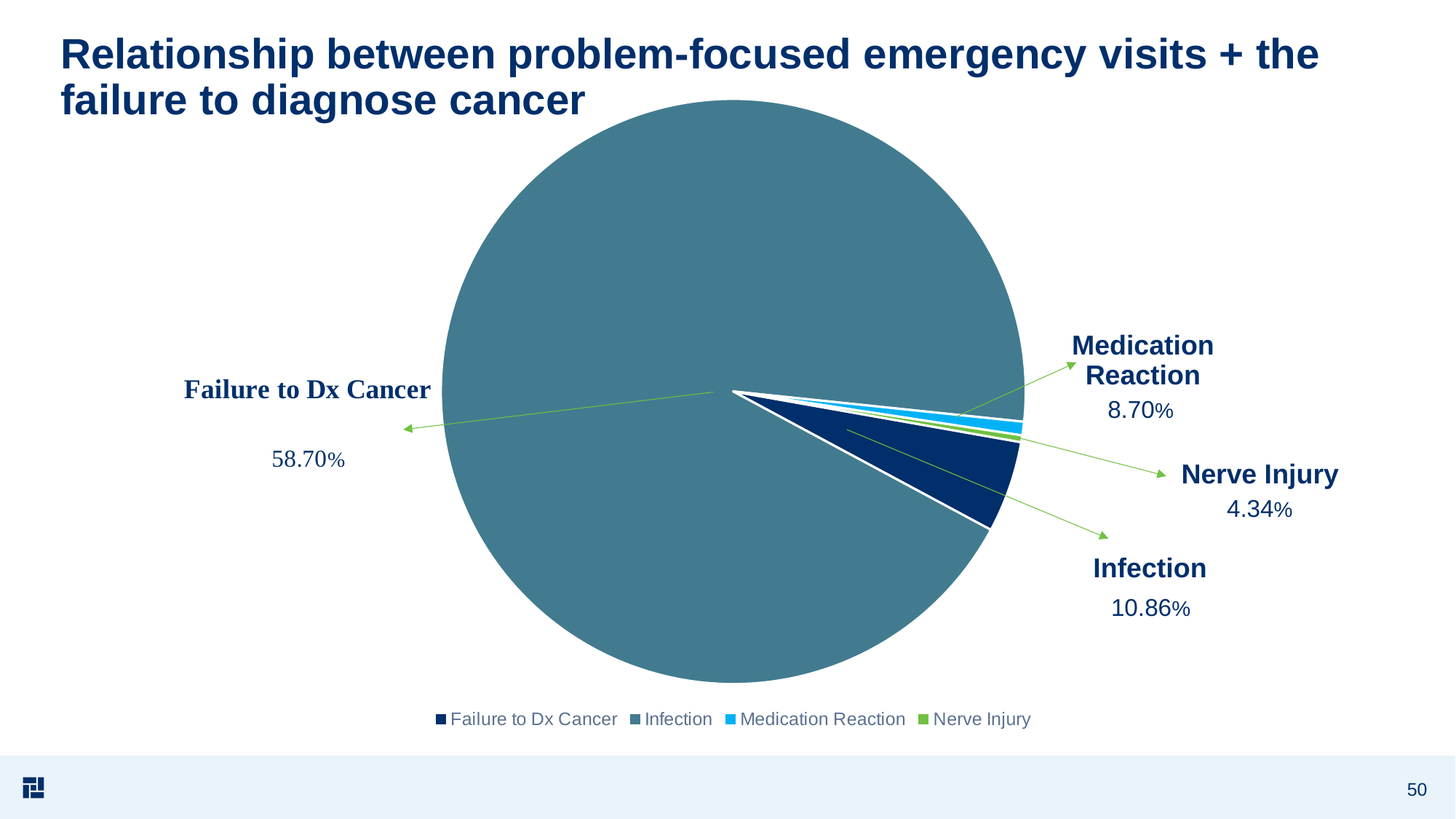
What is the difference between the Infection and Medication Reaction percentages? 2.16% Which category has the largest percentage? Failure to Dx Cancer How many categories are labelled on the pie chart? 4 What percentage is shown for Failure to Dx Cancer? 58.70% What is the title of the slide? Relationship between problem-focused emergency visits + the failure to diagnose cancer What type of chart is shown on the slide? Pie chart What is the difference between the Failure to Dx Cancer and Infection percentages? 47.84% What percentage is shown for Infection? 10.86% What percentage is shown for Medication Reaction? 8.70% Which is larger, Medication Reaction or Nerve Injury? Medication Reaction What percentage is shown for Nerve Injury? 4.34% Which category has the smallest percentage? Nerve Injury